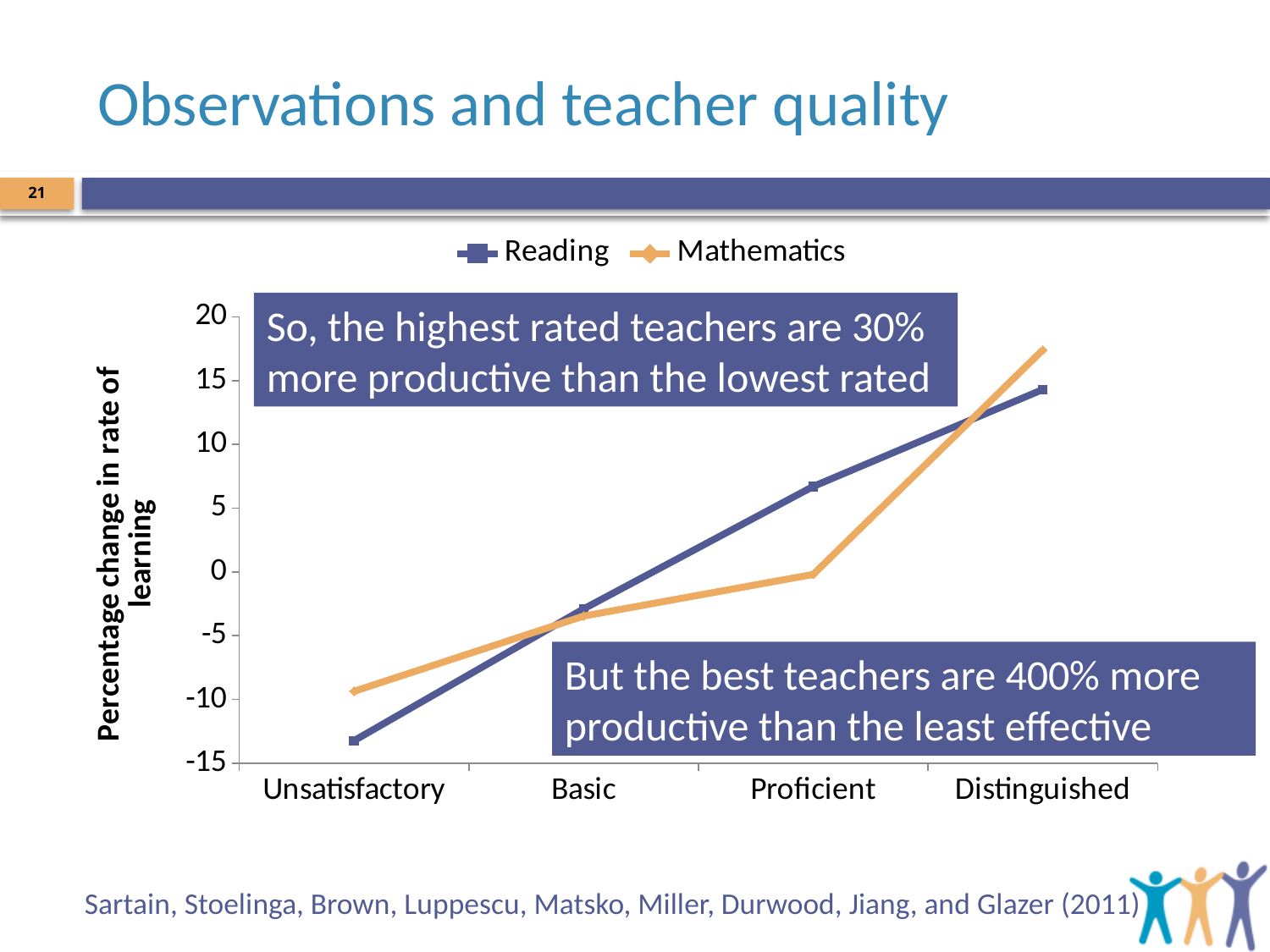
At Proficient, which series has the larger value, Reading or Mathematics? Reading Is the Mathematics value for Distinguished greater or less than 15? greater How many series does the legend list? 2 What is the label of the vertical axis? Percentage change in rate of learning Do the Reading values rise or fall from Unsatisfactory to Distinguished? Rise How many categories are shown on the x axis? 4 What kind of chart is shown on the slide? Line chart Which series are listed in the legend? Reading and Mathematics For which category is the Reading value highest? Distinguished For which category is the Mathematics value lowest? Unsatisfactory Is the Reading value for Proficient greater or less than 5? greater Is the Reading value for Unsatisfactory greater or less than -10? less